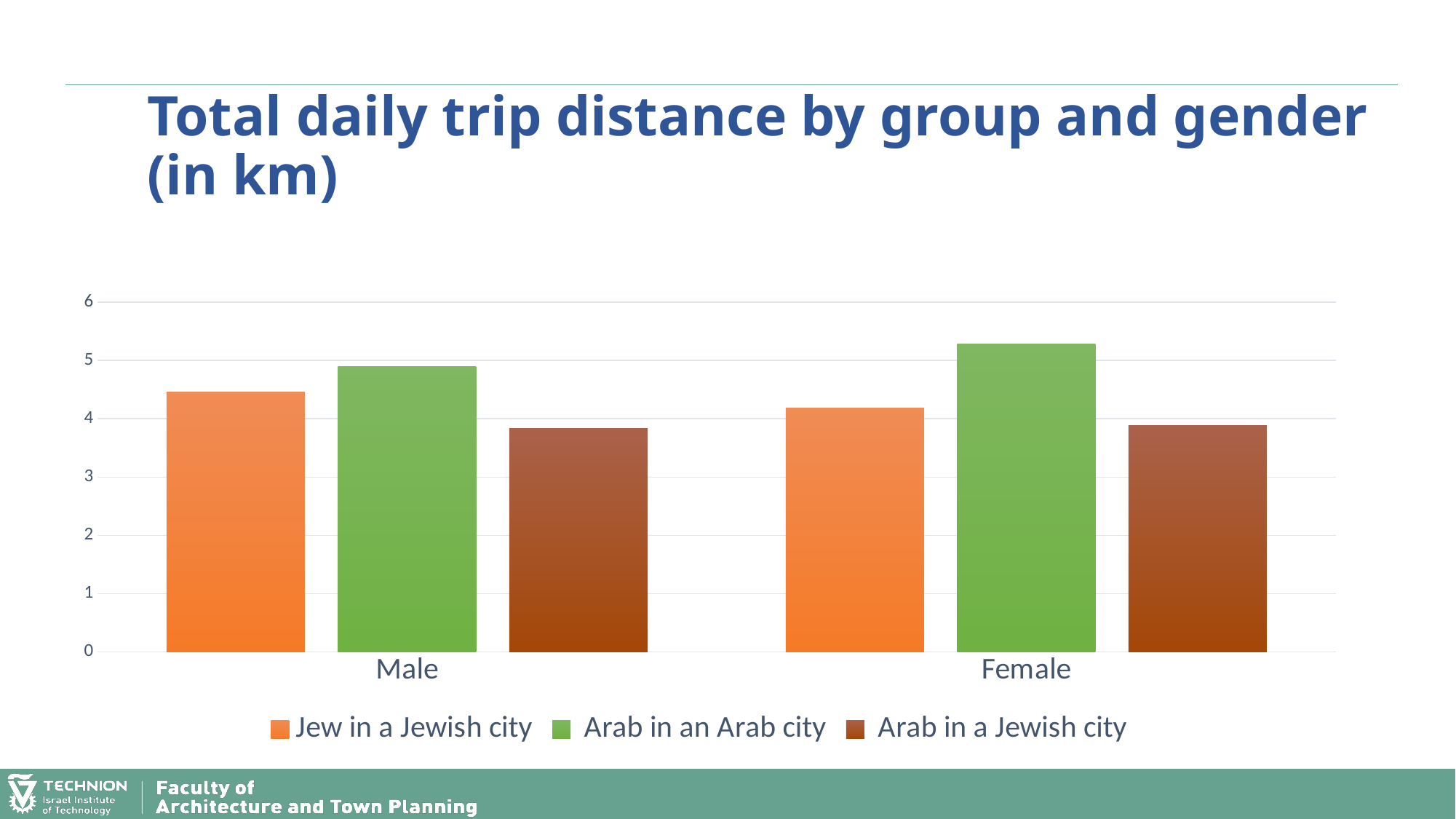
Is the value for Arab in a Jewish city in the Male category greater or less than 4? less Is the value for Jew in a Jewish city in the Male category greater or less than 4? greater Which series has the highest bar in the Female category? Arab in an Arab city What colour represents Arab in an Arab city in the legend? Green What kind of chart is shown on the slide? Bar chart How many gender categories are shown on the x axis? 2 Which series has the lowest bar in the Female category? Arab in a Jewish city How many series does the legend list? 3 Is the value for Arab in an Arab city in the Female category greater or less than 5? greater For Arab in an Arab city, which is larger: the Male value or the Female value? Female Which series has the lowest bar in the Male category? Arab in a Jewish city Which bar is the tallest in the whole chart? Arab in an Arab city, Female